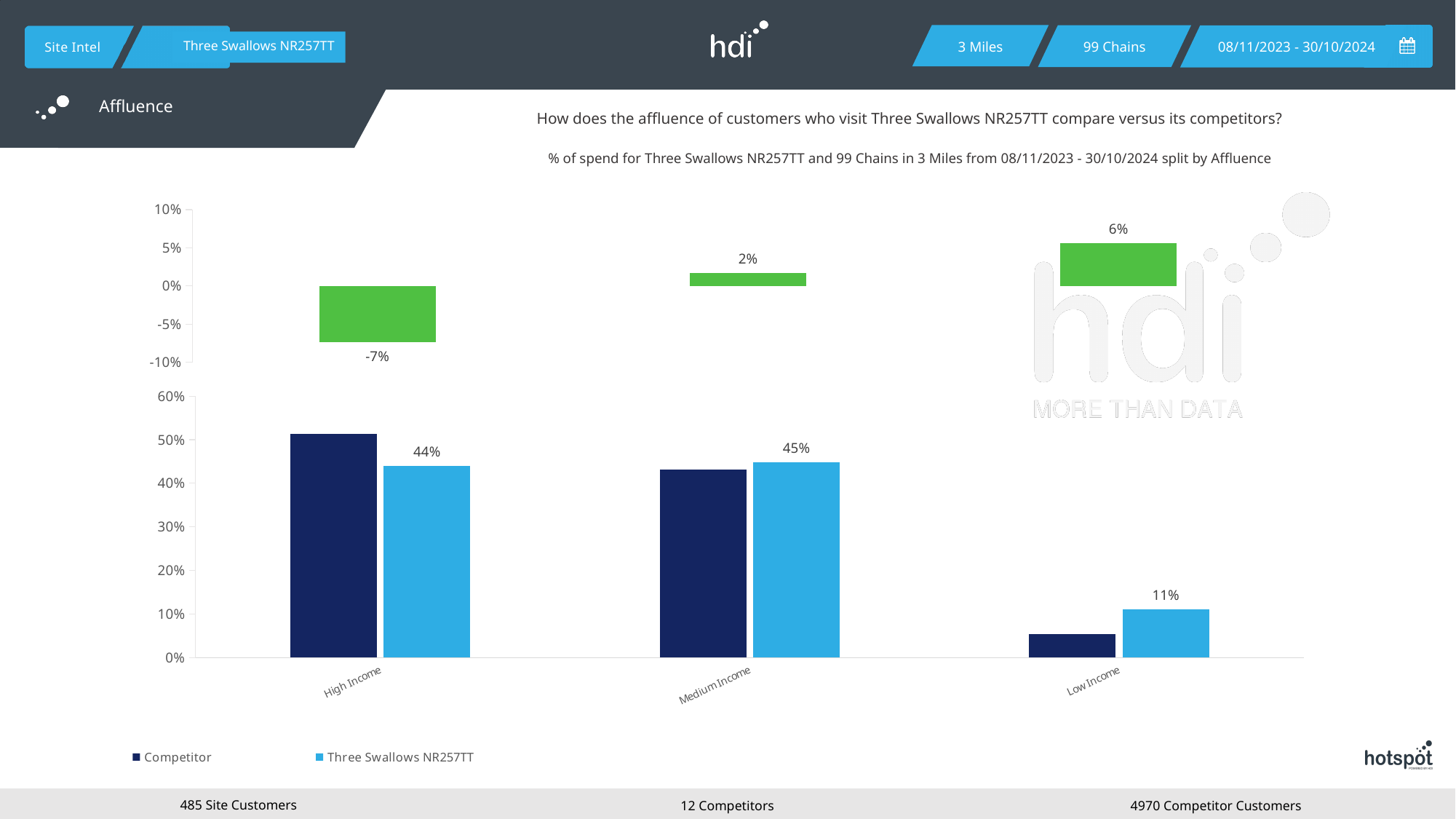
In the bottom chart, what is the difference between the Three Swallows NR257TT values for Medium Income and Low Income? 34% In the bottom chart, what is the value for Three Swallows NR257TT in the Medium Income category? 45% In the bottom chart, which is larger in the High Income category: Competitor or Three Swallows NR257TT? Competitor In the bottom chart, is the Competitor value for High Income greater or less than 50%? greater In the top chart, what is the value shown for the Low Income category? 6% In the top chart, which category has the highest value? Low Income In the bottom chart, what is the value for Three Swallows NR257TT in the Low Income category? 11% In the top chart, what is the value shown for the High Income category? -7% In the bottom chart, what is the value for Three Swallows NR257TT in the High Income category? 44% In the bottom chart, which category has the lowest value for Three Swallows NR257TT? Low Income How many series does the legend of the bottom chart list? 2 What kind of chart is the bottom chart? Bar chart